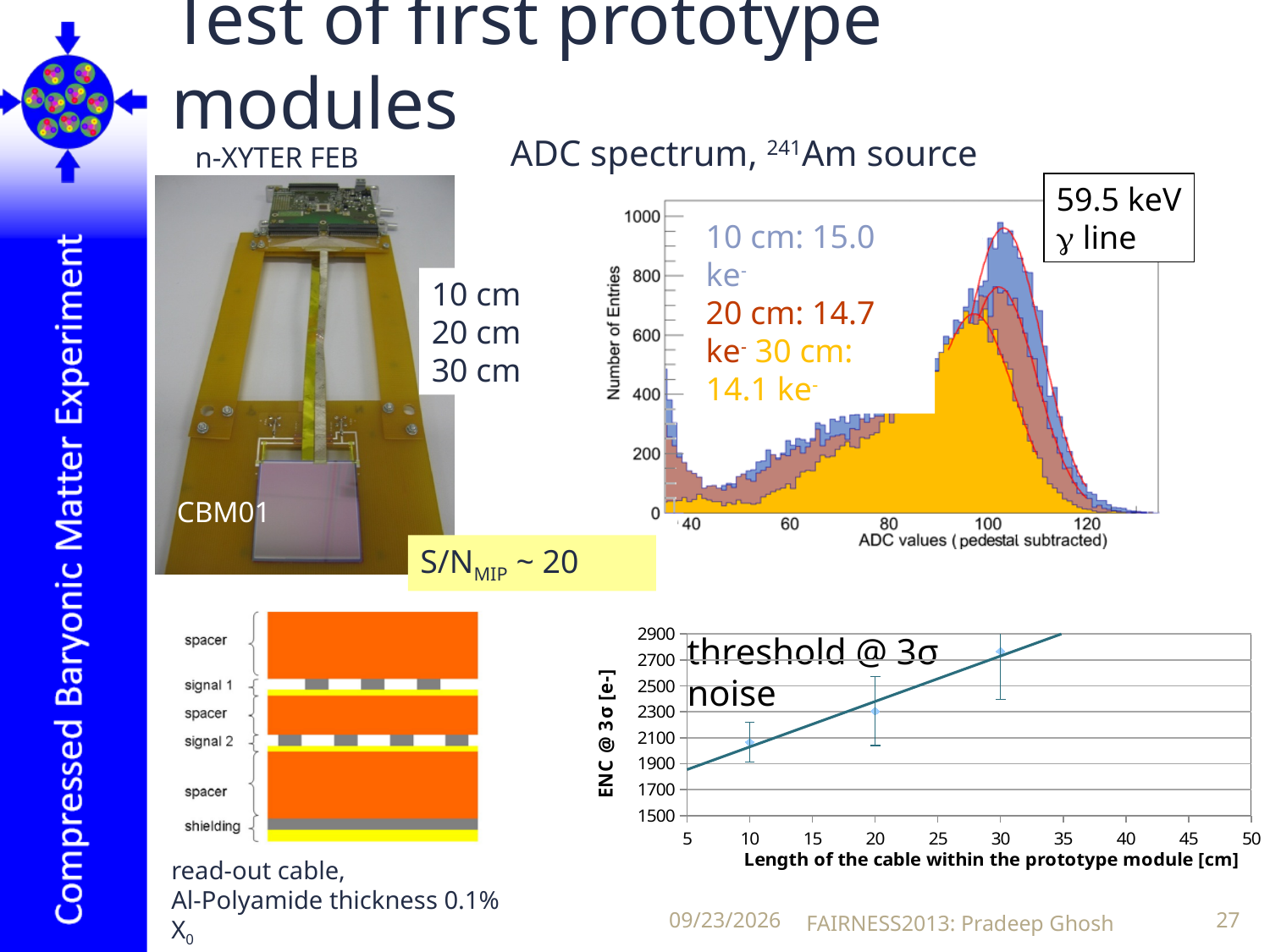
In the bottom-right chart, which cable length has the lowest ENC value? 10 cm In the ADC spectrum chart, what is the label of the x axis? ADC values (pedestal subtracted) In the bottom-right chart, is the ENC value at a cable length of 20 cm greater or less than 2100? greater In the bottom-right chart, what is the label of the x axis? Length of the cable within the prototype module [cm] In the bottom-right chart, how many data points are plotted? 3 In the bottom-right chart, what is the label of the y axis? ENC @ 3σ [e-] In the bottom-right chart, does the ENC rise or fall as the cable length increases? rise In the bottom-right chart, which cable length has the highest ENC value? 30 cm In the ADC spectrum chart, what signal value is annotated for the 20 cm cable? 14.7 ke- In the bottom-right chart, is the ENC value at a cable length of 30 cm greater or less than 2500? greater In the bottom-right chart, is the ENC value at a cable length of 10 cm greater or less than 2300? less In the ADC spectrum chart, what signal value is annotated for the 30 cm cable? 14.1 ke-